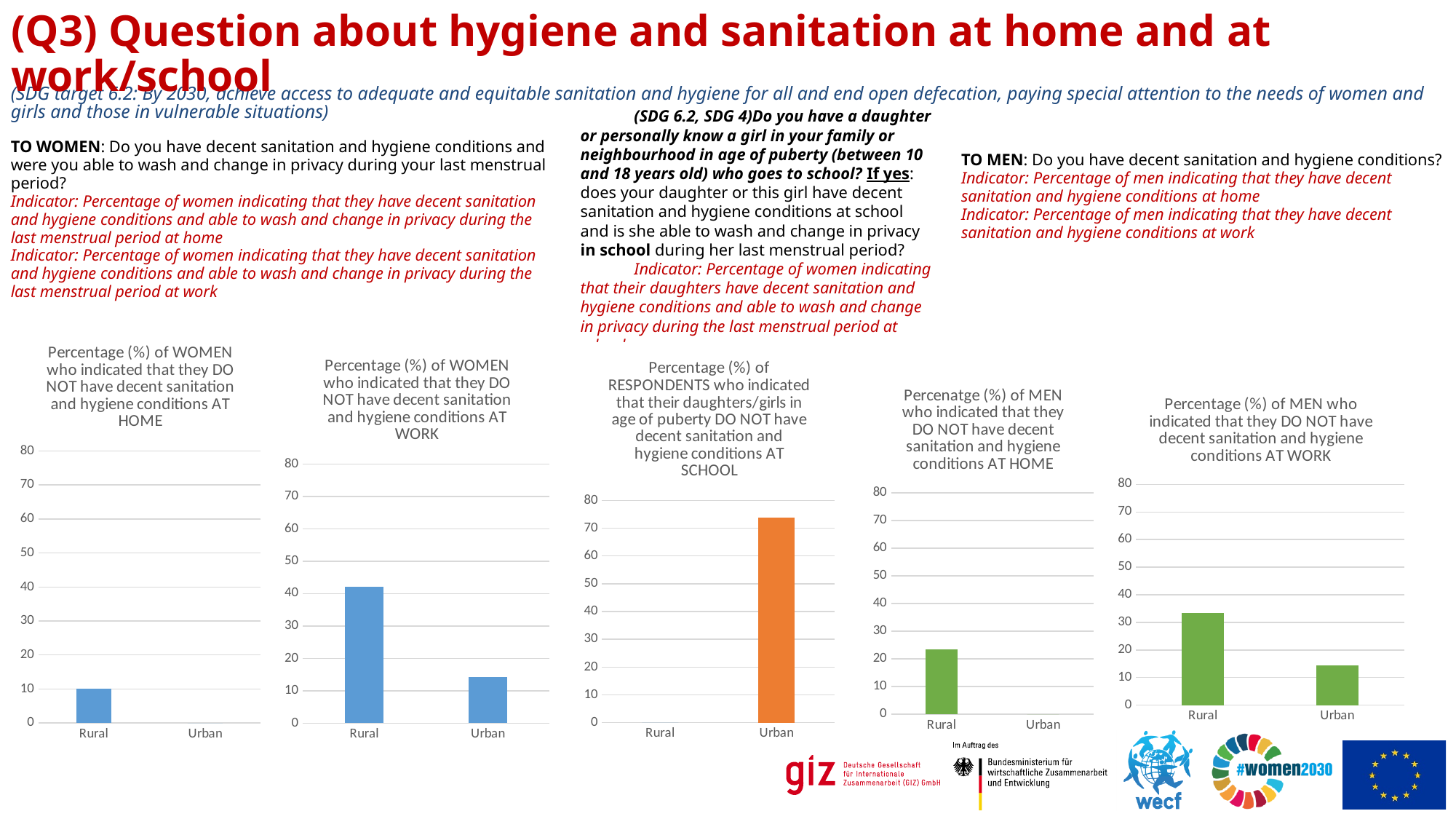
In the chart titled "Percentage (%) of RESPONDENTS who indicated that their daughters/girls in age of puberty DO NOT have decent sanitation and hygiene conditions AT SCHOOL", which category has the highest value? Urban In the chart titled "Percentage (%) of WOMEN who indicated that they DO NOT have decent sanitation and hygiene conditions AT WORK", is the value for Rural greater or less than 40? greater In the chart titled "Percentage (%) of WOMEN who indicated that they DO NOT have decent sanitation and hygiene conditions AT WORK", which category has the higher value, Rural or Urban? Rural In the chart titled "Percentage (%) of MEN who indicated that they DO NOT have decent sanitation and hygiene conditions AT WORK", is the value for Rural greater or less than 30? greater In the chart titled "Percenatge (%) of MEN who indicated that they DO NOT have decent sanitation and hygiene conditions AT HOME", is the value for Rural greater or less than 20? greater In the chart titled "Percentage (%) of MEN who indicated that they DO NOT have decent sanitation and hygiene conditions AT WORK", which category has the lowest value? Urban What colour is the bar in the chart titled "Percentage (%) of RESPONDENTS who indicated that their daughters/girls in age of puberty DO NOT have decent sanitation and hygiene conditions AT SCHOOL"? orange How many categories are shown on the x axis of the chart titled "Percentage (%) of MEN who indicated that they DO NOT have decent sanitation and hygiene conditions AT WORK"? 2 What kind of chart is the chart titled "Percentage (%) of WOMEN who indicated that they DO NOT have decent sanitation and hygiene conditions AT HOME"? bar chart